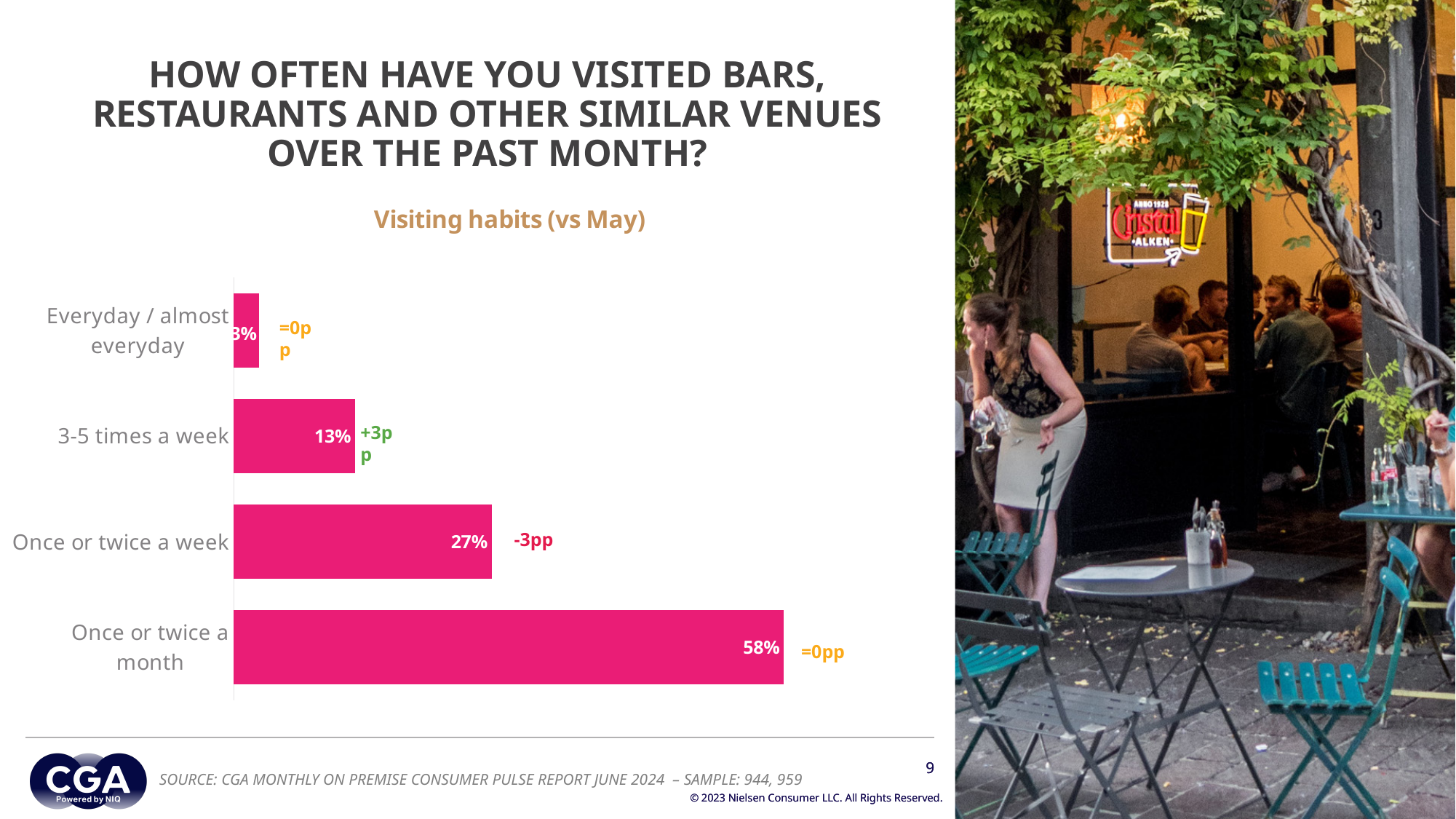
What type of chart is used to show visiting habits? Bar chart What is the title of the chart? Visiting habits (vs May) Which visiting frequency has the highest share of respondents? Once or twice a month What percentage of respondents visited once or twice a week? 27% How many visiting-frequency categories are shown in the chart? 4 What percentage of respondents visited 3-5 times a week? 13% What is the difference in percentage points between 'Once or twice a month' and 'Once or twice a week'? 31 percentage points Which visiting frequency has the lowest share of respondents? Everyday / almost everyday What percentage of respondents visited once or twice a month? 58% What is the difference in percentage points between 'Once or twice a week' and '3-5 times a week'? 14 percentage points Which is larger: the share for '3-5 times a week' or for 'Once or twice a week'? Once or twice a week What change versus May is shown next to the '3-5 times a week' bar? +3pp